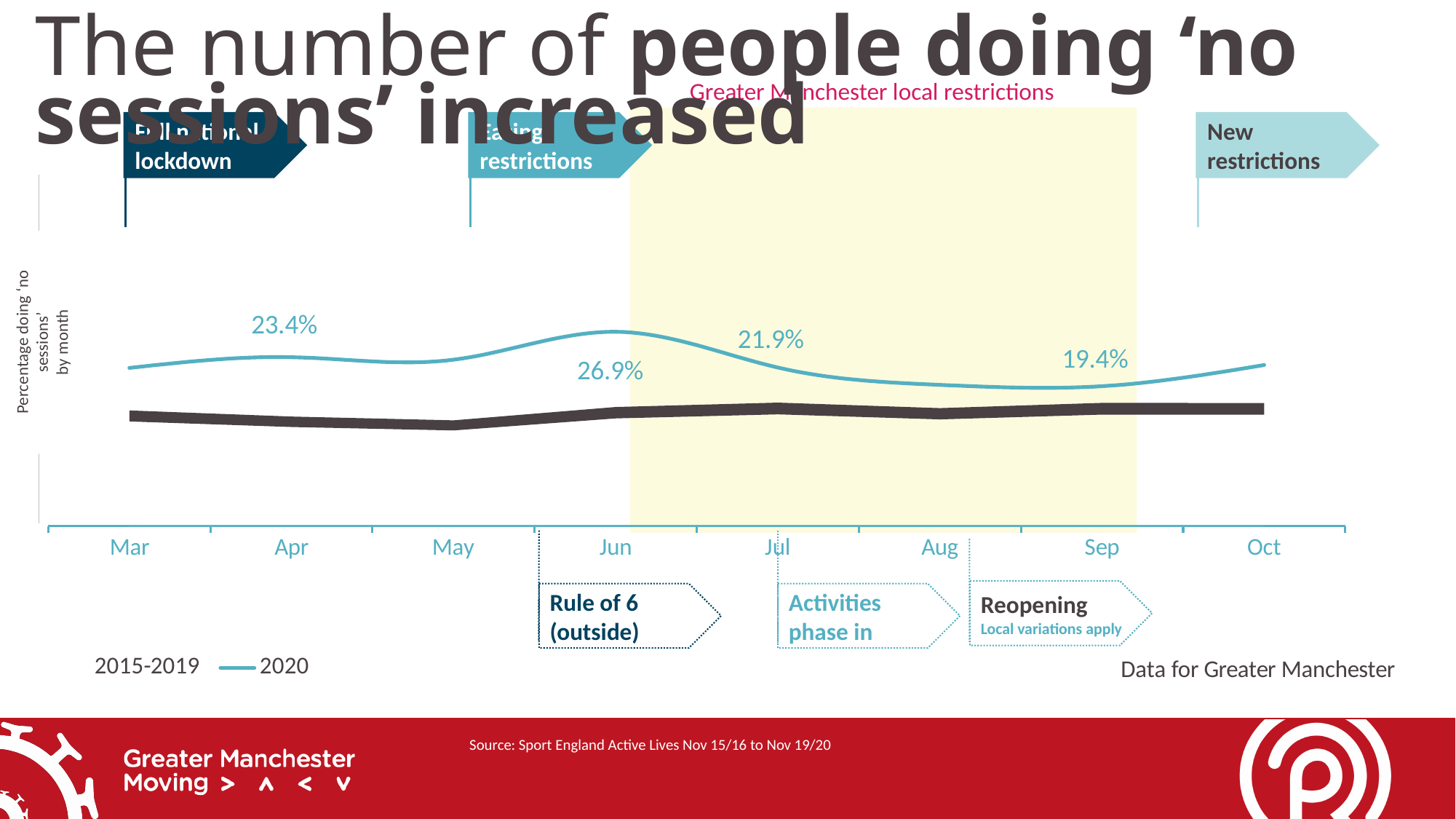
What is the 2020 value for Sep? 19.4% In which month does the 2020 line reach its highest value? Jun What is the 2020 value for Jun? 26.9% What is the difference between the 2020 values for Jun and Jul? 5.0% What is the 2020 value for Jul? 21.9% What kind of chart is shown on the slide? Line chart What is the difference between the 2020 values for Apr and Sep? 4.0% In Jun, which series is higher, 2020 or 2015-2019? 2020 Which is larger, the 2020 value for Apr or for Sep? Apr What is the 2020 value for Apr? 23.4% How many series does the legend list? 2 How many months are shown on the x axis? 8